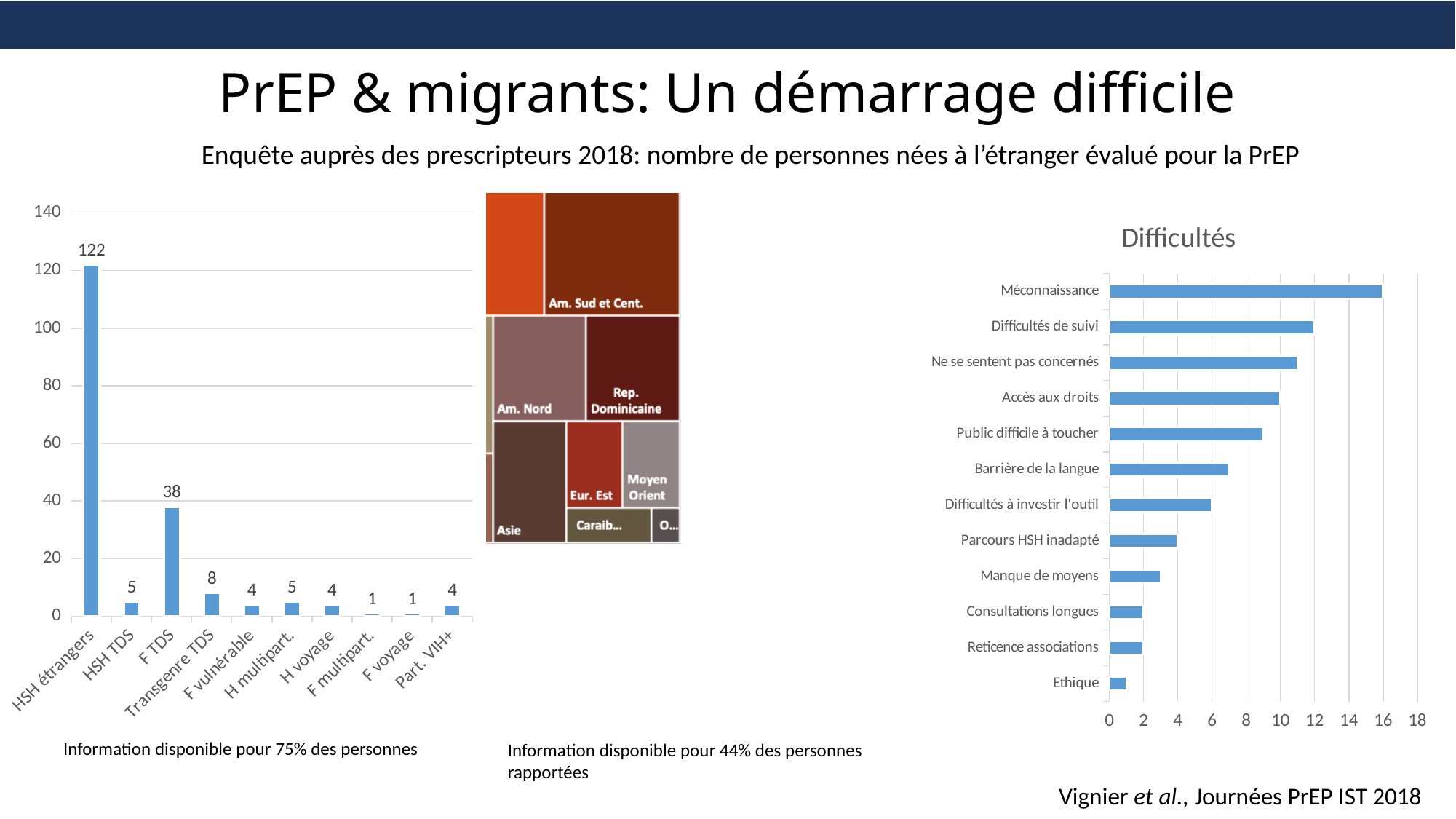
In the Difficultés chart, is the value for Méconnaissance greater or less than 14? greater In the left bar chart, which category has the highest value? HSH étrangers How many categories are shown in the Difficultés chart? 12 In the Difficultés chart, which category has the highest value? Méconnaissance In the Difficultés chart, is the value for Barrière de la langue greater or less than 8? less In the Difficultés chart, which category has the lowest value? Ethique In the left bar chart, which is larger, HSH TDS or Transgenre TDS? Transgenre TDS How many categories are shown in the left bar chart? 10 In the left bar chart, what is the value for HSH étrangers? 122 In the left bar chart, what is the value for Transgenre TDS? 8 In the left bar chart, what is the value for F TDS? 38 In the left bar chart, what is the difference between HSH étrangers and F TDS? 84